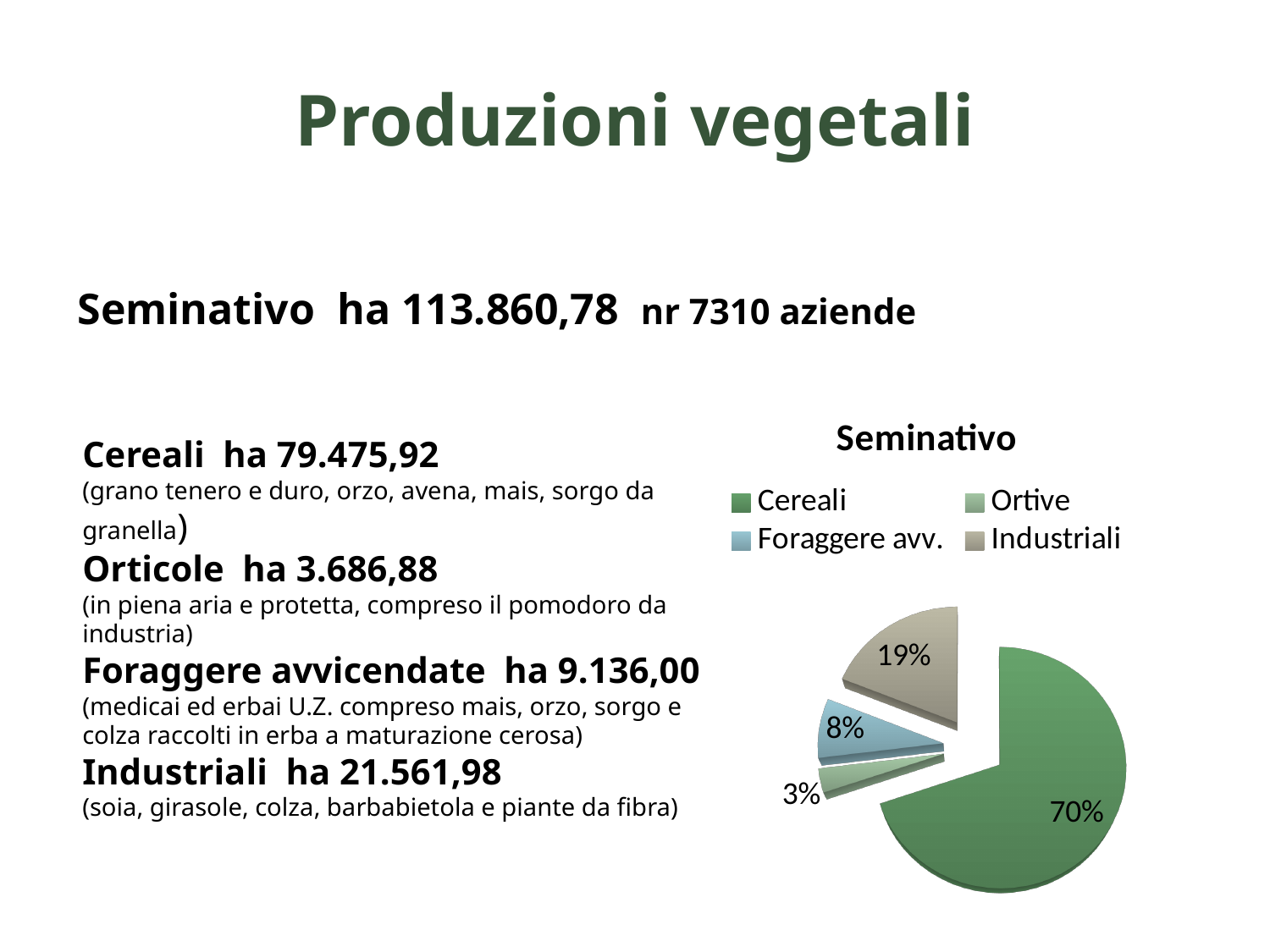
What share of the pie does Ortive represent? 3% Which slice is larger, Foraggere avv. or Industriali? Industriali What kind of chart is shown on the slide? pie chart What share of the pie does Industriali represent? 19% What is the title of the chart? Seminativo Which category has the smallest slice of the pie? Ortive What is the difference in percentage points between the Industriali and Foraggere avv. slices? 11 How many slices does the pie chart have? 4 How many entries does the chart legend list? 4 What share of the pie does Foraggere avv. represent? 8% Which category has the largest slice of the pie? Cereali